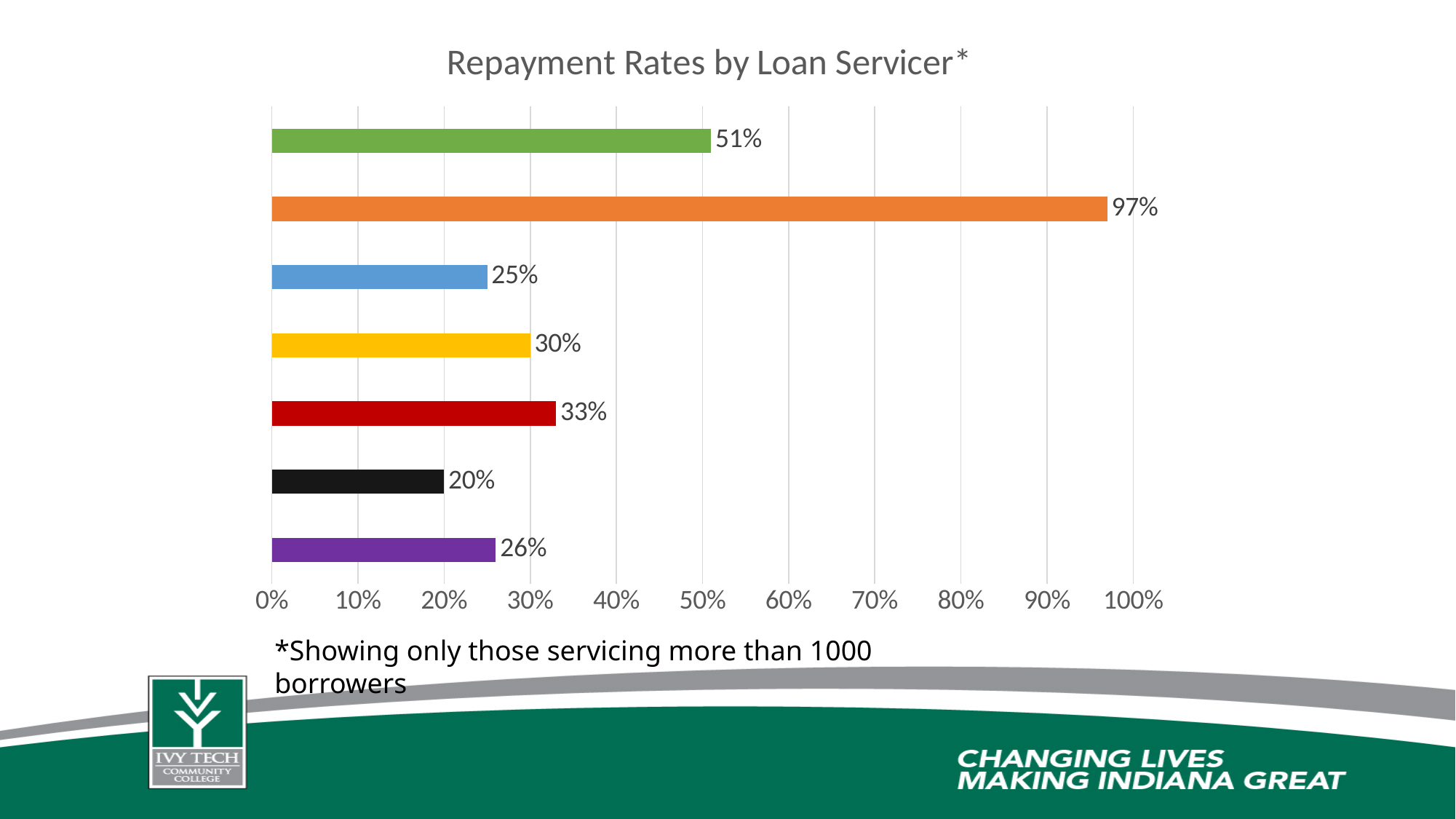
Which is larger, the value of the red bar or the value of the yellow bar? the red bar (33%) What value is shown for the orange bar? 97% What value is shown for the green bar at the top of the chart? 51% Which bar has the lowest repayment rate? the black bar (20%) What value is shown for the purple bar at the bottom of the chart? 26% What does the footnote below the chart say? *Showing only those servicing more than 1000 borrowers What is the title of the chart? Repayment Rates by Loan Servicer* What value is shown for the black bar? 20% What is the difference between the orange bar's value and the green bar's value? 46% Which bar has the highest repayment rate? the orange bar (97%) What kind of chart is shown on the slide? bar chart How many bars are plotted in the chart? 7